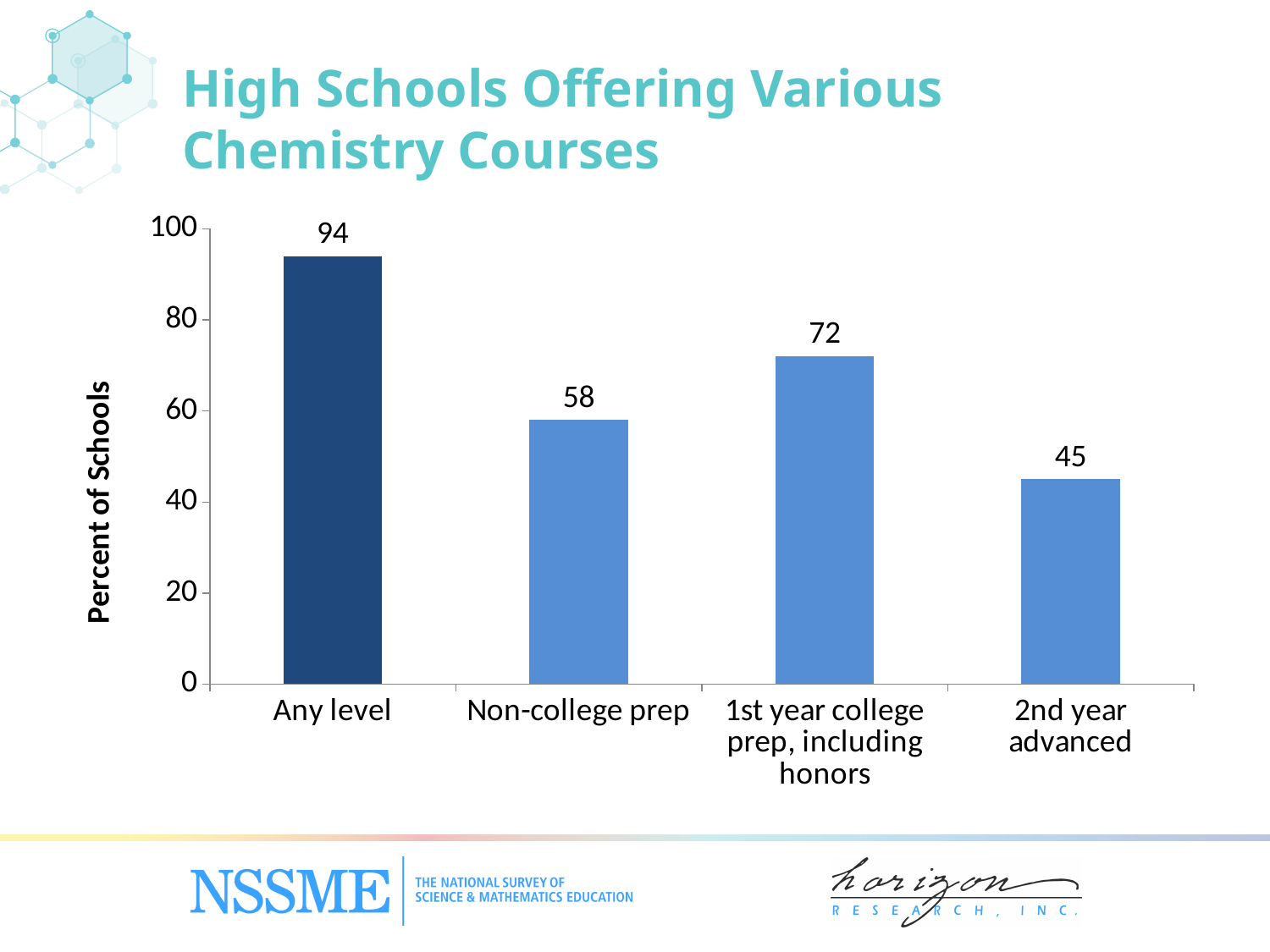
What is the value for Non-college prep? 58 What is the label of the vertical axis? Percent of Schools How many categories are shown in the chart? 4 Which category has the lowest value? 2nd year advanced What percent of schools offer chemistry at any level? 94 Which category has the highest value? Any level What is the value for 2nd year advanced? 45 What is the difference between the values for 1st year college prep, including honors and Non-college prep? 14 What is the difference between the values for Any level and 2nd year advanced? 49 Which is larger, the value for Non-college prep or the value for 1st year college prep, including honors? 1st year college prep, including honors What is the value for 1st year college prep, including honors? 72 What kind of chart is shown on the slide? Bar chart